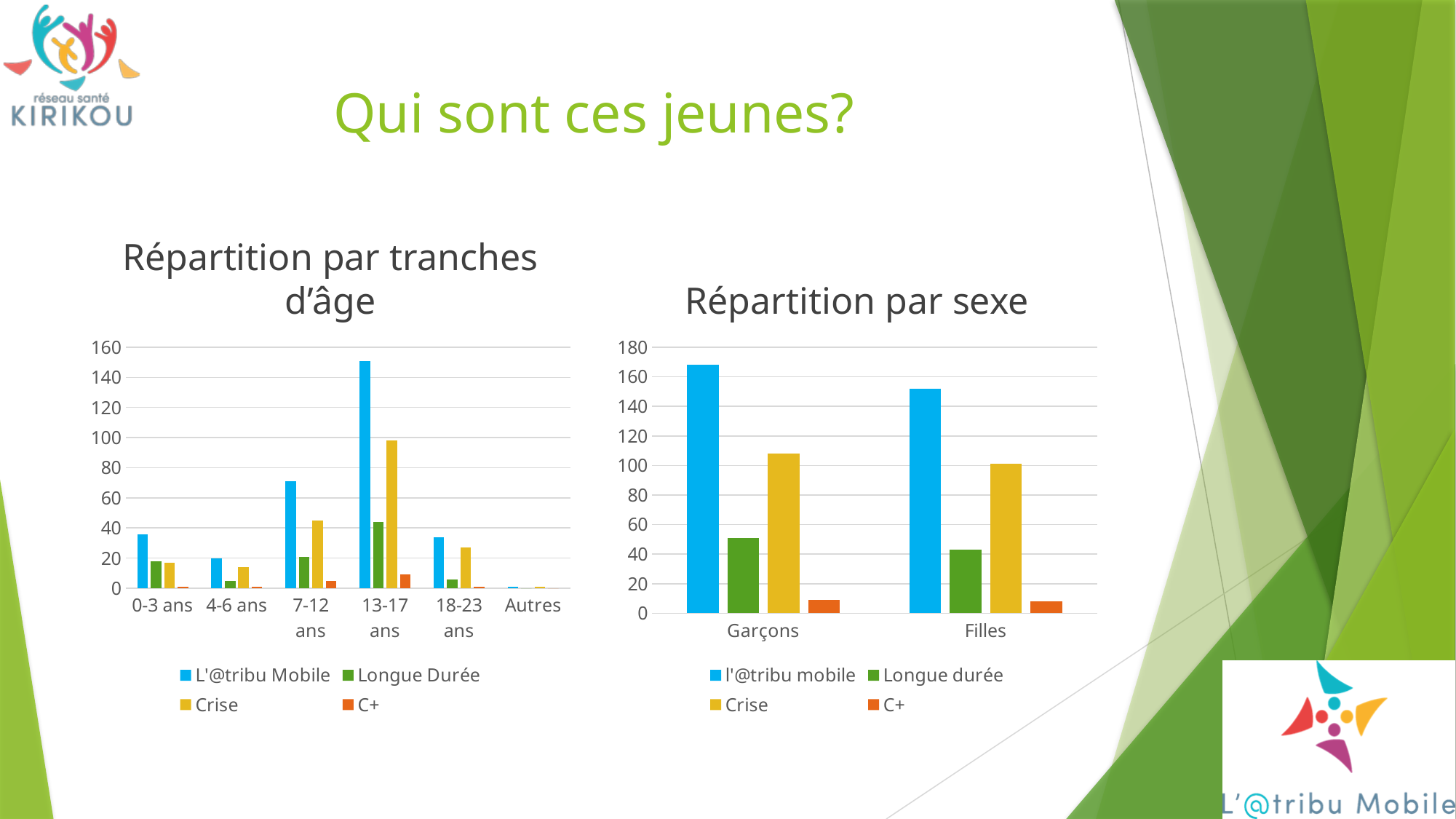
In the chart 'Répartition par tranches d'âge', is the Crise value for 13-17 ans greater or less than 80? greater What kind of chart is 'Répartition par sexe'? bar chart In the chart 'Répartition par tranches d'âge', how many series does the legend list? 4 In the chart 'Répartition par tranches d'âge', is the L'@tribu Mobile value for 13-17 ans greater or less than 140? greater In the chart 'Répartition par tranches d'âge', how many age categories are shown on the x axis? 6 In the chart 'Répartition par tranches d'âge', which age group has the highest value for L'@tribu Mobile? 13-17 ans In the chart 'Répartition par sexe', which series has the lowest value for Garçons? C+ In the chart 'Répartition par sexe', which category has the higher value for l'@tribu mobile: Garçons or Filles? Garçons In the chart 'Répartition par sexe', how many categories are shown on the x axis? 2 In the chart 'Répartition par sexe', is the l'@tribu mobile value for Garçons greater or less than 160? greater In the chart 'Répartition par tranches d'âge', which is larger for 7-12 ans: L'@tribu Mobile or Crise? L'@tribu Mobile